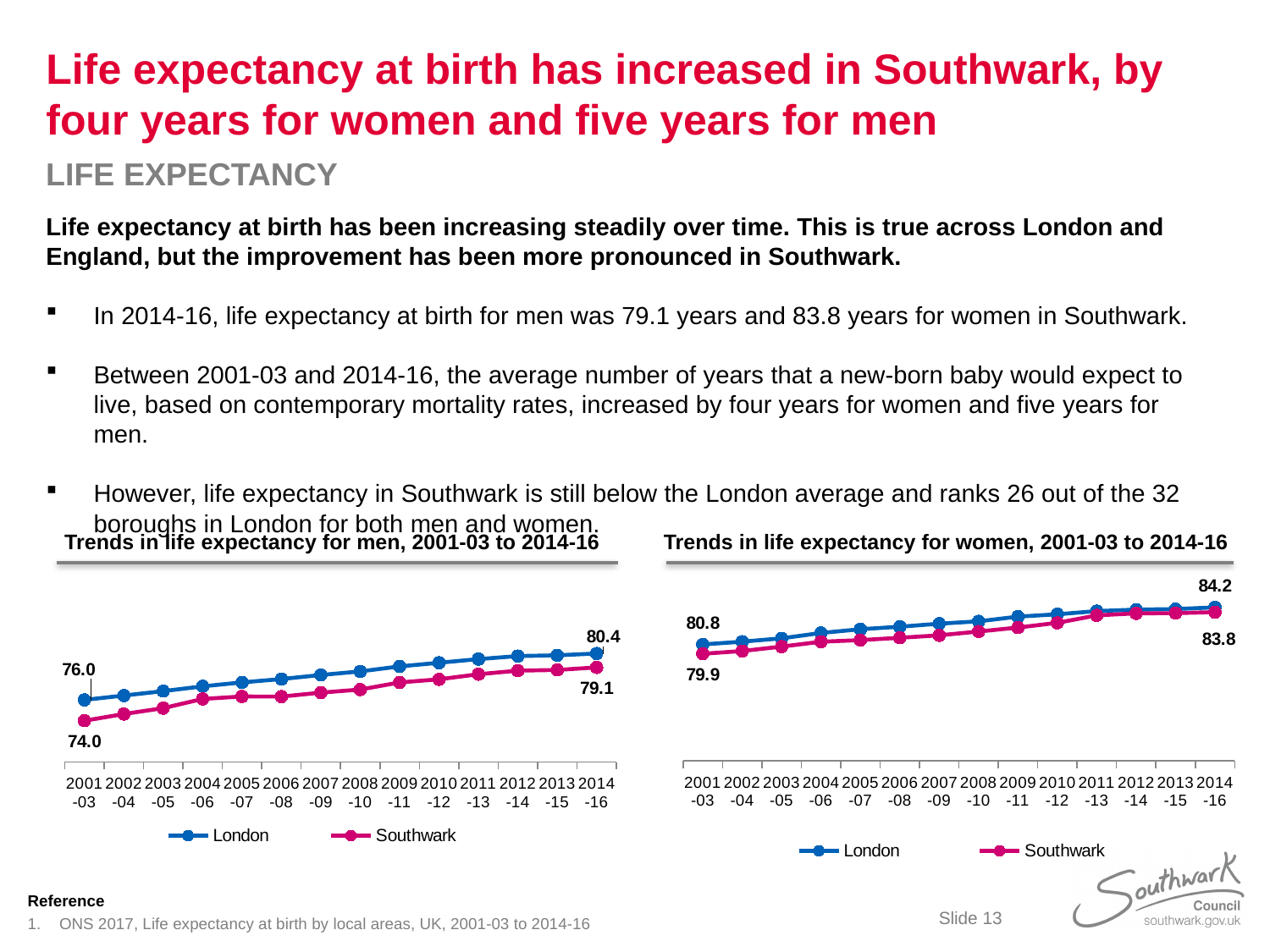
In the 'Trends in life expectancy for men' chart, what was the Southwark value in 2001-03? 74.0 In the 'Trends in life expectancy for men' chart, which series has the higher value in 2001-03, London or Southwark? London How many time periods are shown on the x axis of the 'Trends in life expectancy for men' chart? 14 How many series does the legend of the 'Trends in life expectancy for women' chart list? 2 In the 'Trends in life expectancy for women' chart, which colour is used for the Southwark line? Pink In the 'Trends in life expectancy for men' chart, what was the London value in 2014-16? 80.4 In the 'Trends in life expectancy for women' chart, what was the Southwark value in 2014-16? 83.8 In the 'Trends in life expectancy for women' chart, what is the difference between the London and Southwark values in 2014-16? 0.4 In the 'Trends in life expectancy for women' chart, what was the London value in 2001-03? 80.8 In the 'Trends in life expectancy for women' chart, does the Southwark line rise or fall from 2001-03 to 2014-16? Rise What type of chart is the 'Trends in life expectancy for men' chart? Line chart In the 'Trends in life expectancy for men' chart, by how much did the Southwark value increase between 2001-03 and 2014-16? 5.1